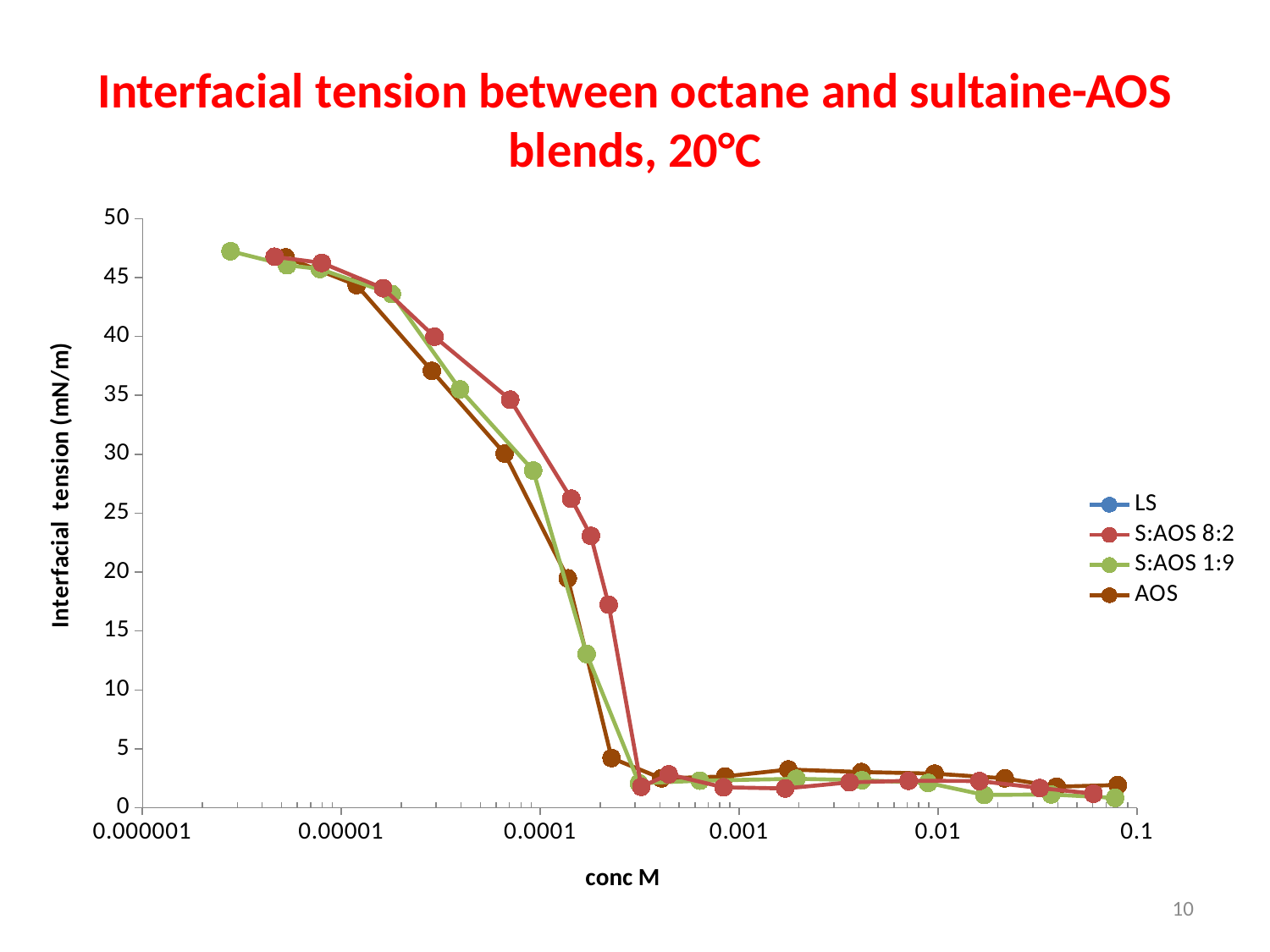
Is the interfacial tension for AOS at 0.1 M greater or less than 5? less Is the highest interfacial tension plotted on the chart greater or less than 45? greater Around 0.0002 M, which series has the higher interfacial tension, S:AOS 8:2 or AOS? S:AOS 8:2 What kind of chart is shown on the slide? line chart Is the interfacial tension for S:AOS 8:2 at 0.001 M greater or less than 5? less Do the interfacial tension values rise or fall as concentration increases along the x axis? fall What is the label of the y axis? Interfacial tension (mN/m) What is the title of the chart? Interfacial tension between octane and sultaine-AOS blends, 20°C How many series does the legend list? 4